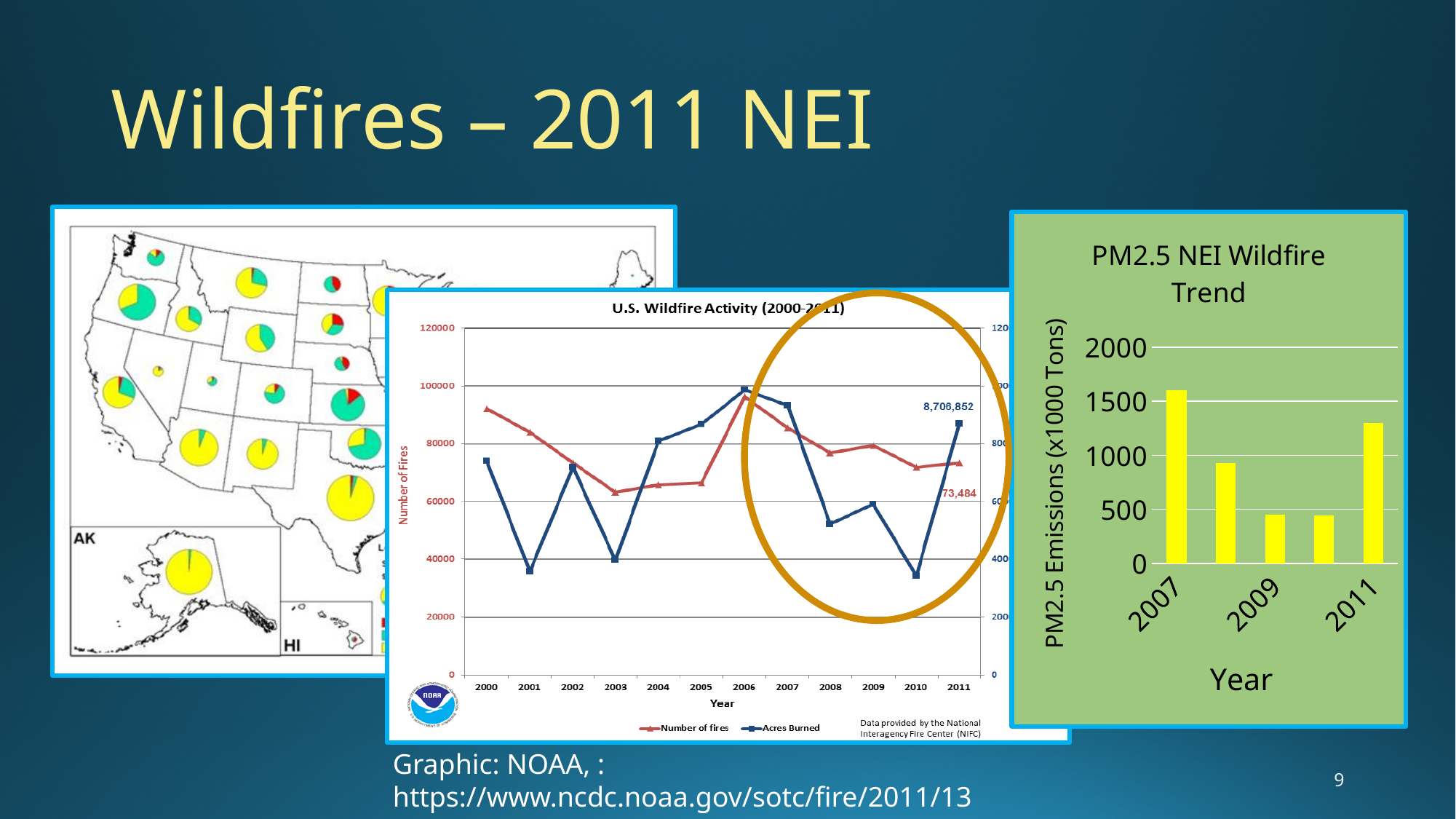
On the PM2.5 NEI Wildfire Trend chart, what kind of chart is used? bar chart On the U.S. Wildfire Activity (2000-2011) chart, what is the labeled Number of fires in 2011? 73,484 On the PM2.5 NEI Wildfire Trend chart, is the value for 2007 greater or less than 1500? greater On the U.S. Wildfire Activity (2000-2011) chart, what is the labeled value of Acres Burned in 2011? 8,706,852 On the PM2.5 NEI Wildfire Trend chart, which is larger, the value for 2008 or the value for 2011? 2011 On the PM2.5 NEI Wildfire Trend chart, how many years (bars) are plotted? 5 On the PM2.5 NEI Wildfire Trend chart, is the value for 2011 greater or less than 1000? greater On the PM2.5 NEI Wildfire Trend chart, what is the label of the vertical axis? PM2.5 Emissions (x1000 Tons) On the U.S. Wildfire Activity (2000-2011) chart, how many series does the legend list? 2 On the PM2.5 NEI Wildfire Trend chart, is the value for 2009 greater or less than 500? less On the PM2.5 NEI Wildfire Trend chart, which year has the highest PM2.5 emissions? 2007